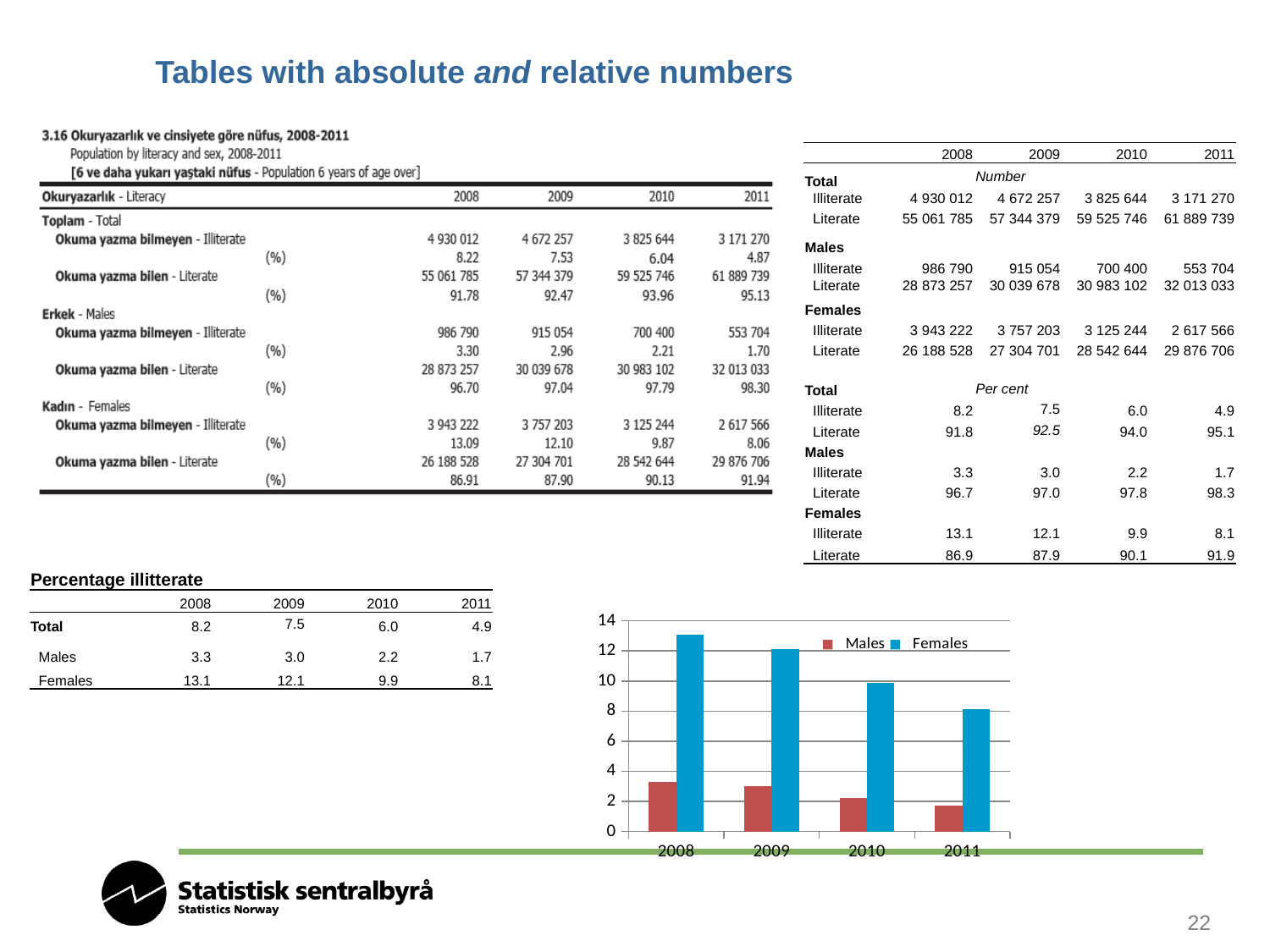
Which series and year has the shortest bar in the chart? Males, 2011 What colour are the Females bars in the chart? blue Is the Females bar for 2008 greater or less than 12? greater Do the Females bars rise or fall from 2008 to 2011? fall Is the Females bar for 2011 greater or less than 10? less How many series does the chart's legend list? 2 How many years are shown along the x axis of the chart? 4 What kind of chart is shown on the slide? bar chart Which series and year has the tallest bar in the chart? Females, 2008 Is the Males bar for 2008 greater or less than 2? greater In the chart, which is larger: the Females bar for 2008 or the Females bar for 2011? Females 2008